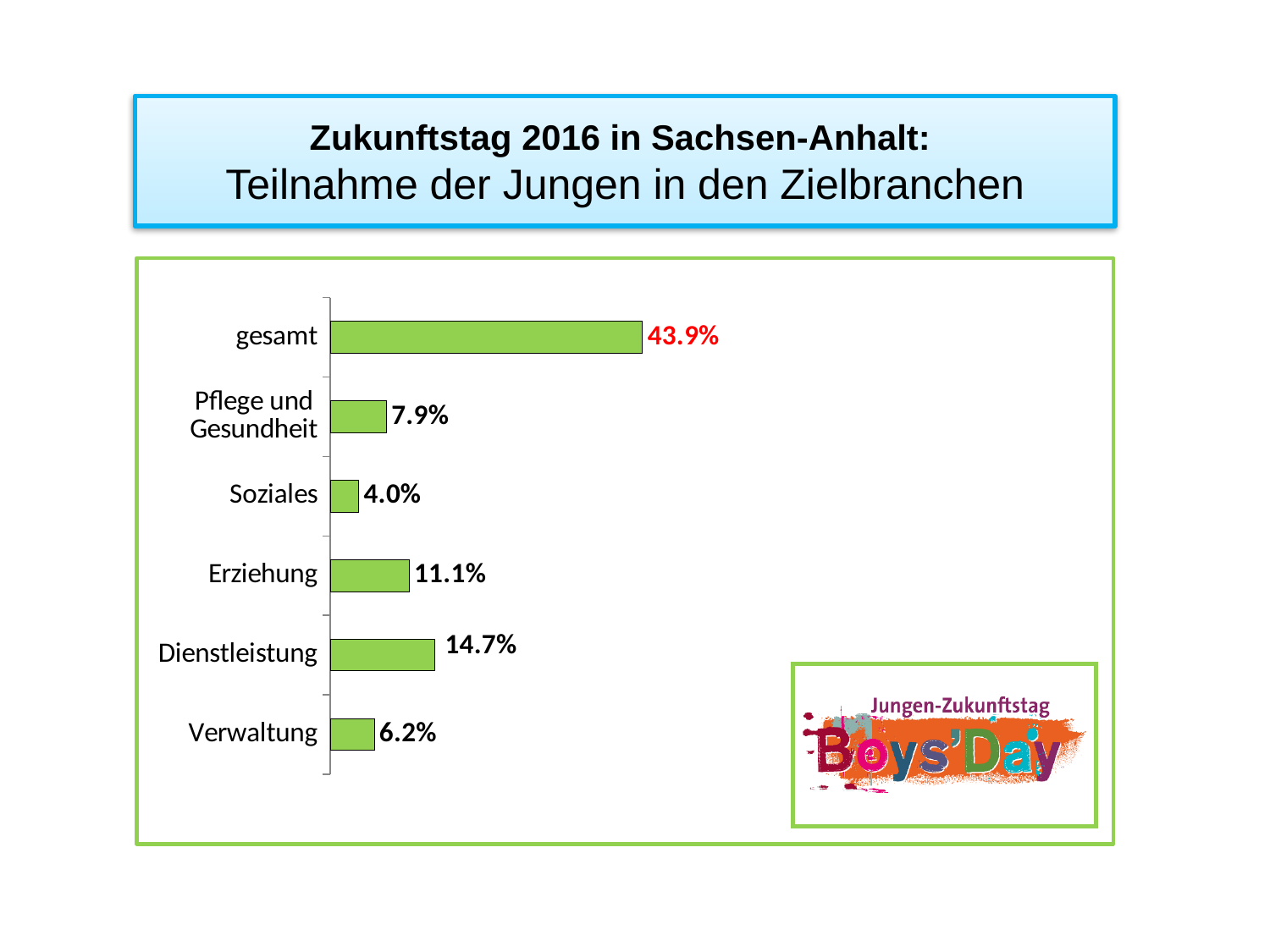
What colour are the bars in the chart? Green Which category has the lowest value? Soziales How many categories are shown in the chart? 6 What is the value for gesamt? 43.9% What is the value for Pflege und Gesundheit? 7.9% What is the difference between the values for gesamt and Soziales? 39.9% What kind of chart is shown on the slide? Bar chart What is the difference between the values for Dienstleistung and Erziehung? 3.6% Which is larger, the value for Pflege und Gesundheit or the value for Verwaltung? Pflege und Gesundheit What is the value for Erziehung? 11.1% What is the value for Verwaltung? 6.2% Which category has the highest value? gesamt